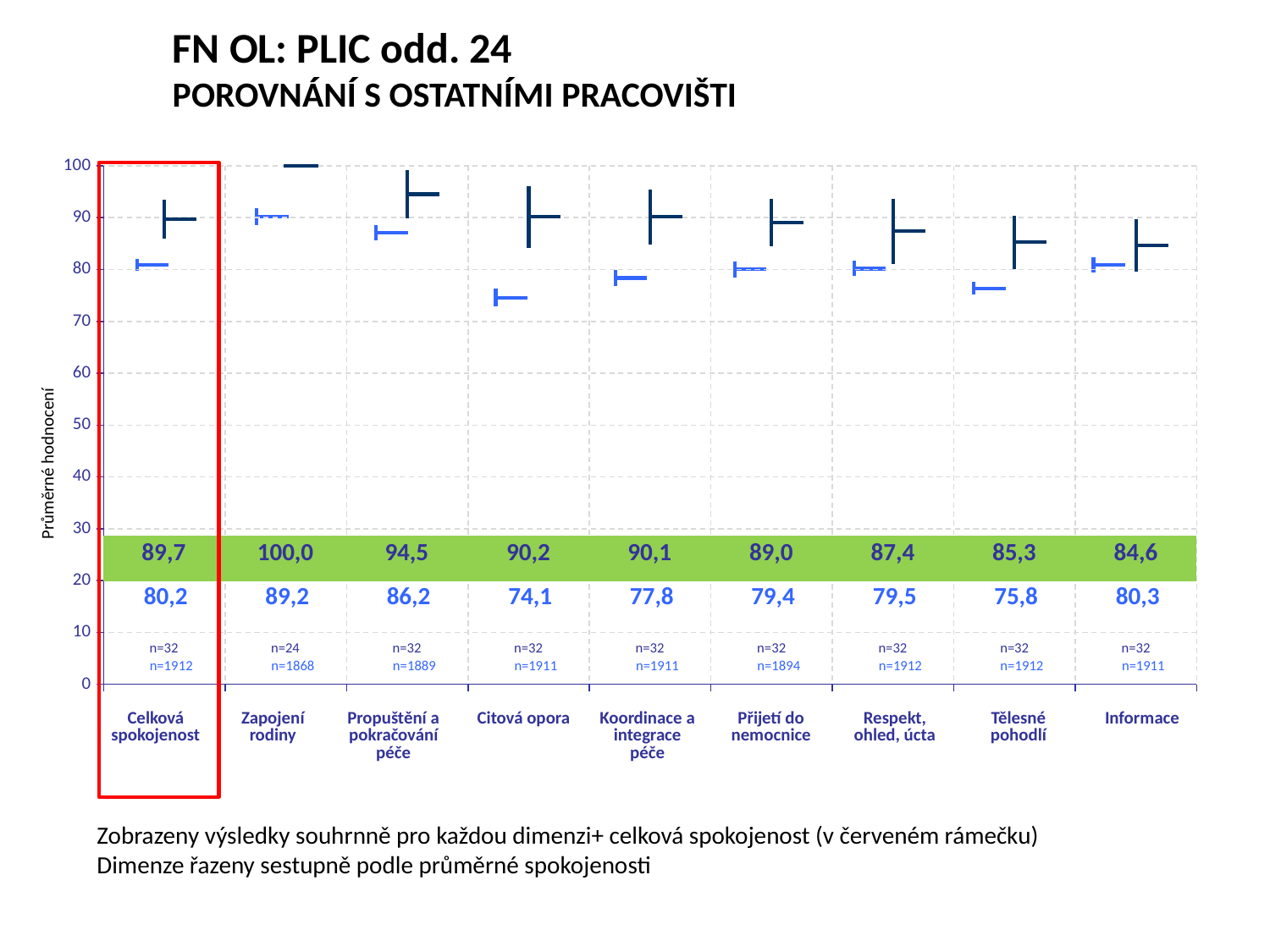
Which category has the highest upper value (in the green band)? Zapojení rodiny What is the lower value (below the green band) shown for Informace? 80,3 Which category has the lowest lower value (below the green band)? Citová opora How many categories are shown along the x axis? 9 What is the upper value (in the green band) shown for Celková spokojenost? 89,7 What is the label of the y axis? Průměrné hodnocení Do the upper values (in the green band) rise or fall from Zapojení rodiny to Informace along the x axis? fall What is the n value printed on the first line for Zapojení rodiny? n=24 What is the lower value (below the green band) shown for Citová opora? 74,1 Which is larger: the lower value for Zapojení rodiny or the lower value for Tělesné pohodlí? Zapojení rodiny What is the upper value (in the green band) shown for Propuštění a pokračování péče? 94,5 What is the difference between the upper and lower values for Celková spokojenost? 9,5